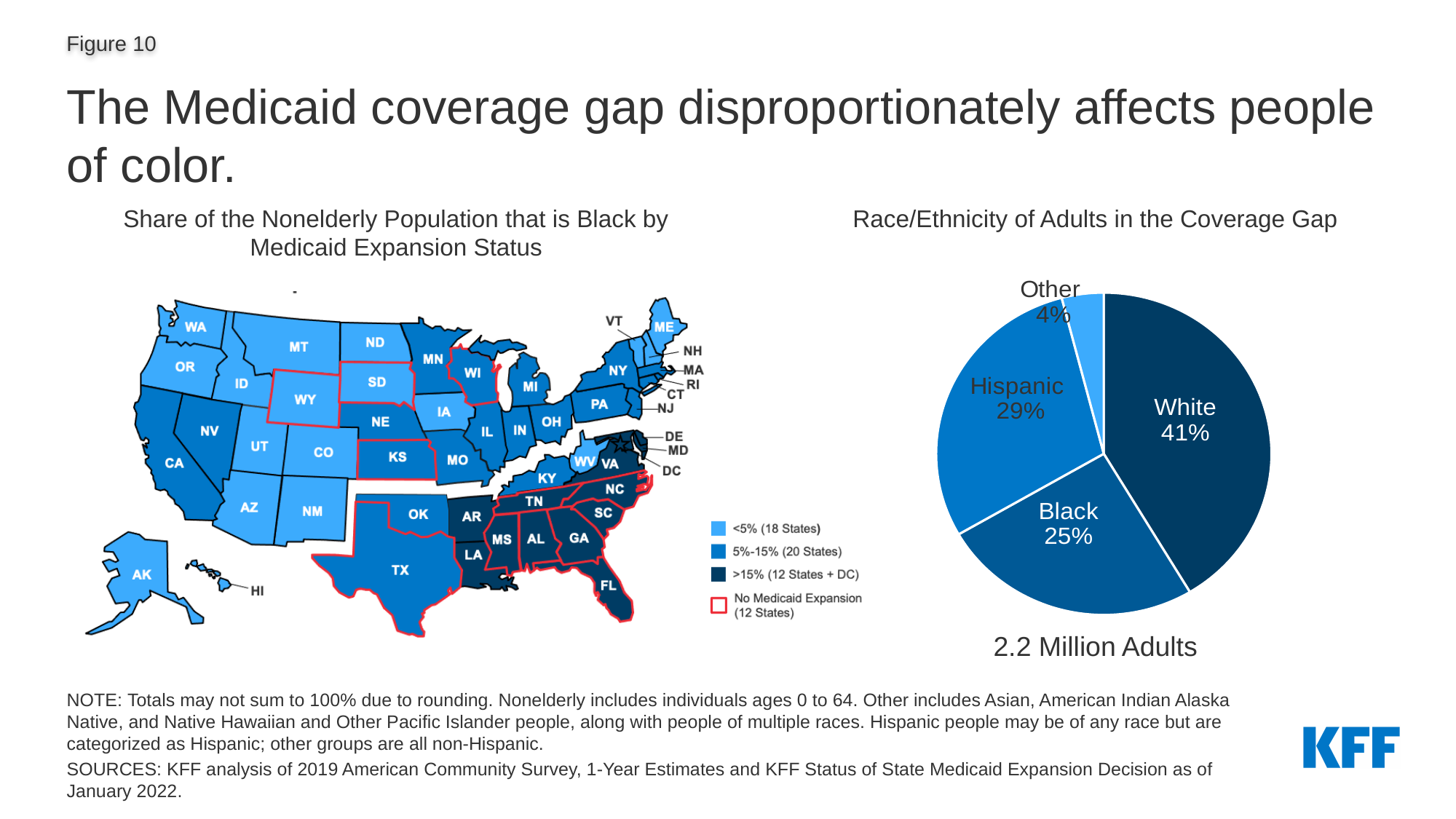
What kind of chart is used for 'Race/Ethnicity of Adults in the Coverage Gap'? Pie chart In the pie chart 'Race/Ethnicity of Adults in the Coverage Gap', which group has the smallest share? Other In the pie chart 'Race/Ethnicity of Adults in the Coverage Gap', what share of adults in the coverage gap is Hispanic? 29% In the pie chart 'Race/Ethnicity of Adults in the Coverage Gap', which group has the largest share? White In the pie chart 'Race/Ethnicity of Adults in the Coverage Gap', how many percentage points larger is the White share than the Black share? 16 percentage points In the map 'Share of the Nonelderly Population that is Black by Medicaid Expansion Status', how many states are in the '<5%' category according to the legend? 18 States In the pie chart 'Race/Ethnicity of Adults in the Coverage Gap', which share is larger, Hispanic or Black? Hispanic How many slices does the pie chart 'Race/Ethnicity of Adults in the Coverage Gap' have? 4 According to the label below the pie chart, how many adults are in the coverage gap? 2.2 Million Adults In the pie chart 'Race/Ethnicity of Adults in the Coverage Gap', what share is labeled Other? 4% In the pie chart 'Race/Ethnicity of Adults in the Coverage Gap', what share of adults in the coverage gap is White? 41% In the pie chart 'Race/Ethnicity of Adults in the Coverage Gap', what share of adults in the coverage gap is Black? 25%